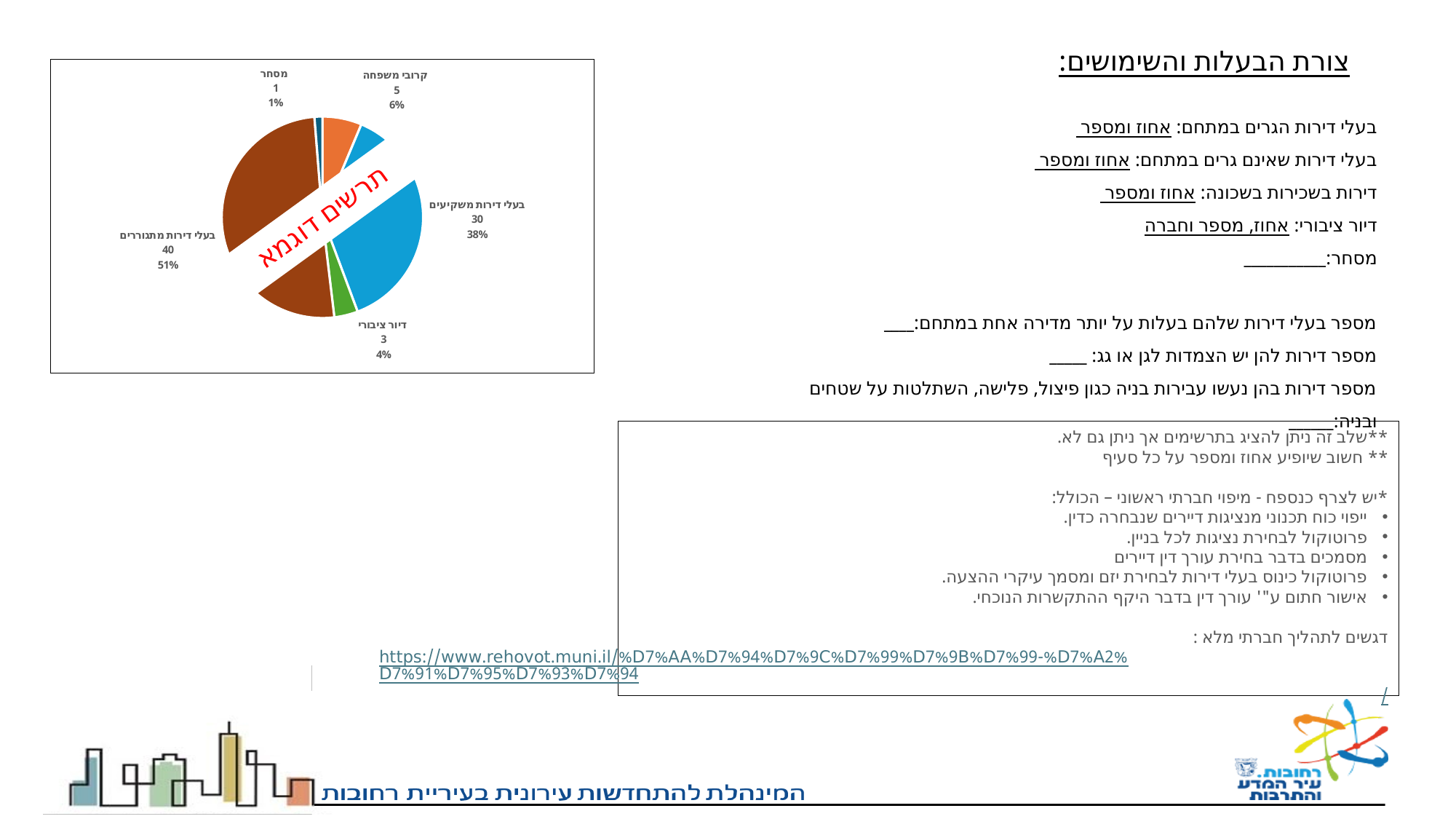
What text is written diagonally across the pie chart as a watermark? תרשים דוגמא Which category has the largest slice in the pie chart? בעלי דירות מתגוררים What is the count shown for מסחר in the pie chart? 1 What kind of chart is shown on the slide? pie chart Which has a larger count in the pie chart, קרובי משפחה or דיור ציבורי? קרובי משפחה Which category has the smallest slice in the pie chart? מסחר What is the count shown for דיור ציבורי in the pie chart? 3 What percentage share does בעלי דירות משקיעים have in the pie chart? 38% What percentage share does קרובי משפחה have in the pie chart? 6% How many slices does the pie chart have? 5 What is the difference in count between בעלי דירות מתגוררים and בעלי דירות משקיעים in the pie chart? 10 What is the count shown for בעלי דירות מתגוררים in the pie chart? 40